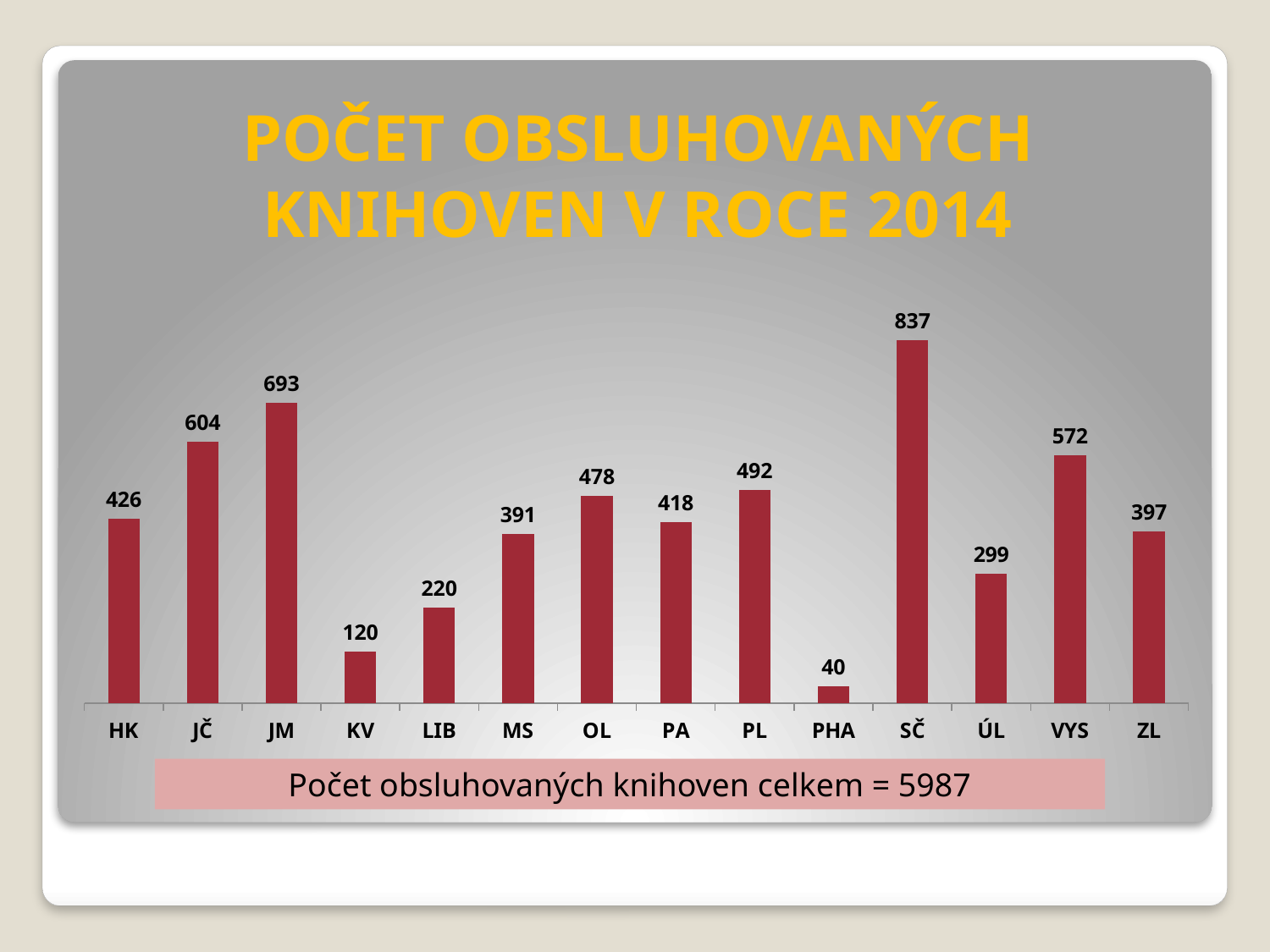
Which is larger, the value for HK or the value for PA? HK What is the difference between the values for SČ and PHA? 797 What is the value for VYS? 572 What is the difference between the values for JM and JČ? 89 Which category has the lowest value? PHA What is the value for SČ? 837 Which category has the highest value? SČ What is the value for KV? 120 How many categories are shown on the x axis? 14 Which is larger, the value for OL or the value for PL? PL What total is stated in the box below the chart? 5987 What kind of chart is shown on the slide? bar chart